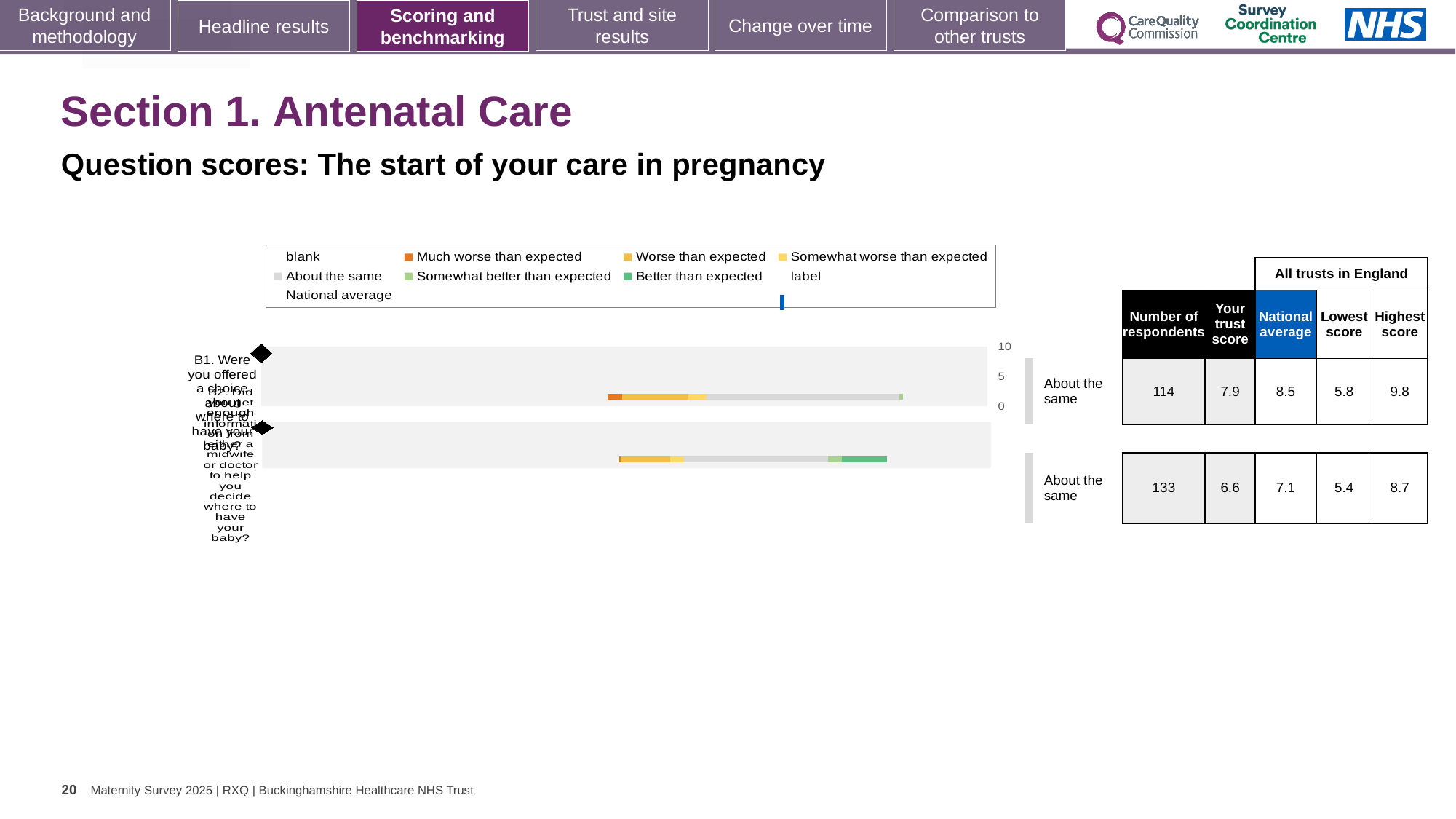
What is the national average for question B2? 7.1 What kind of chart is used to show the question scores on this slide? bar chart What is the lowest score among all trusts in England for question B1? 5.8 What is the difference between the national average and the trust score for question B1? 0.6 How many respondents answered question B1? 114 What colour does the legend use for 'Much worse than expected'? orange What is the highest score among all trusts in England for question B2? 8.7 Which question has the higher trust score, B1 or B2? B1 How many questions (categories) are plotted in the chart? 2 What benchmark category is shown for question B2? About the same What is the trust score for question B1 (Were you offered a choice about where to have your baby?)? 7.9 How many more respondents answered question B2 than question B1? 19